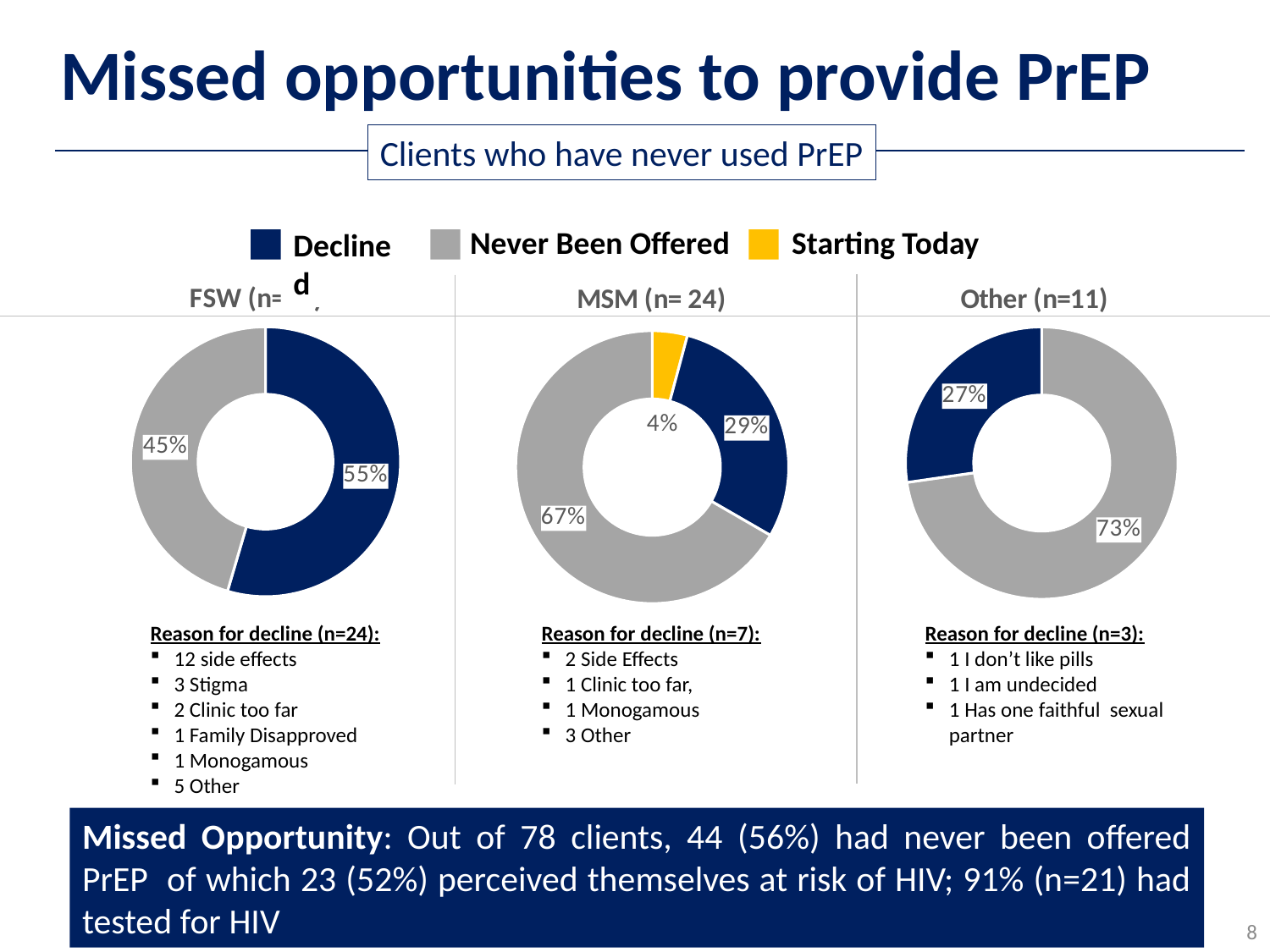
In the FSW chart, which is larger: the Declined share or the Never Been Offered share? Declined What type of chart is used for the Other (n=11) group? Donut (pie) chart How many slices does the MSM (n= 24) chart have? 3 How many categories does the shared legend list? 3 In the Other (n=11) chart, which category has the largest share? Never Been Offered In the MSM (n= 24) chart, what is the difference between the Never Been Offered share and the Declined share? 38 percentage points In the Other (n=11) chart, what percentage of clients declined PrEP? 27% In the MSM (n= 24) chart, what percentage of clients had never been offered PrEP? 67% In the MSM (n= 24) chart, what percentage of clients are starting PrEP today? 4% In the FSW chart, what percentage of clients had never been offered PrEP? 45% In the MSM (n= 24) chart, which category has the smallest share? Starting Today In the FSW chart, what percentage of clients declined PrEP? 55%